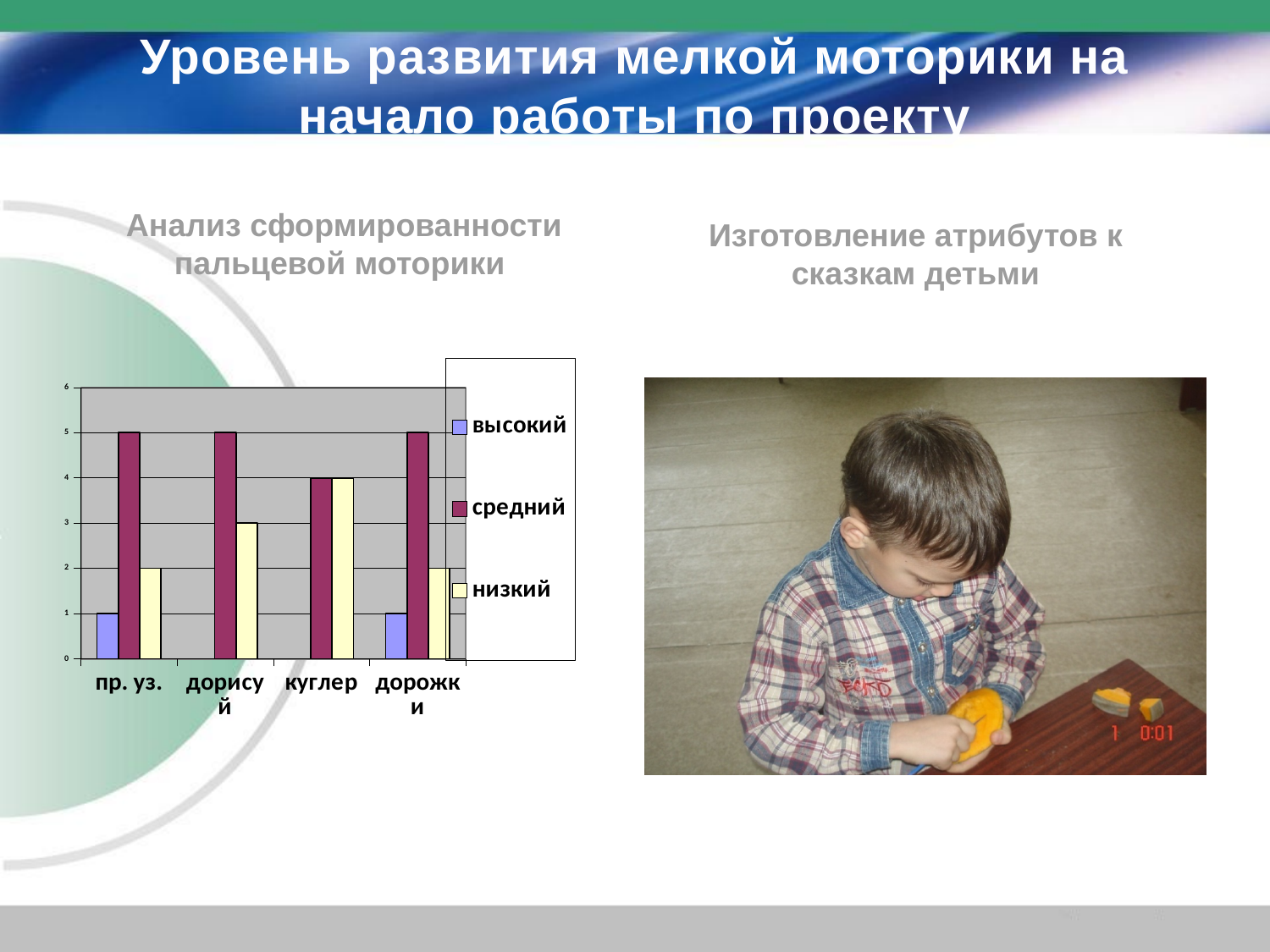
How many categories are shown on the x axis of the chart? 4 Which category has the highest value for the низкий series? куглер What is the value of the средний series for куглер? 4 What kind of chart is shown on the slide? bar chart What is the value of the низкий series for дорисуй? 3 What is the difference between the средний and низкий values for пр. уз.? 3 What is the value of the средний series for пр. уз.? 5 What is the value of the высокий series for дорожки? 1 Which category has the lowest value for the средний series? куглер How many series does the chart legend list? 3 Which is larger for дорисуй: the средний value or the низкий value? средний Which series in the legend is shown in yellow? низкий